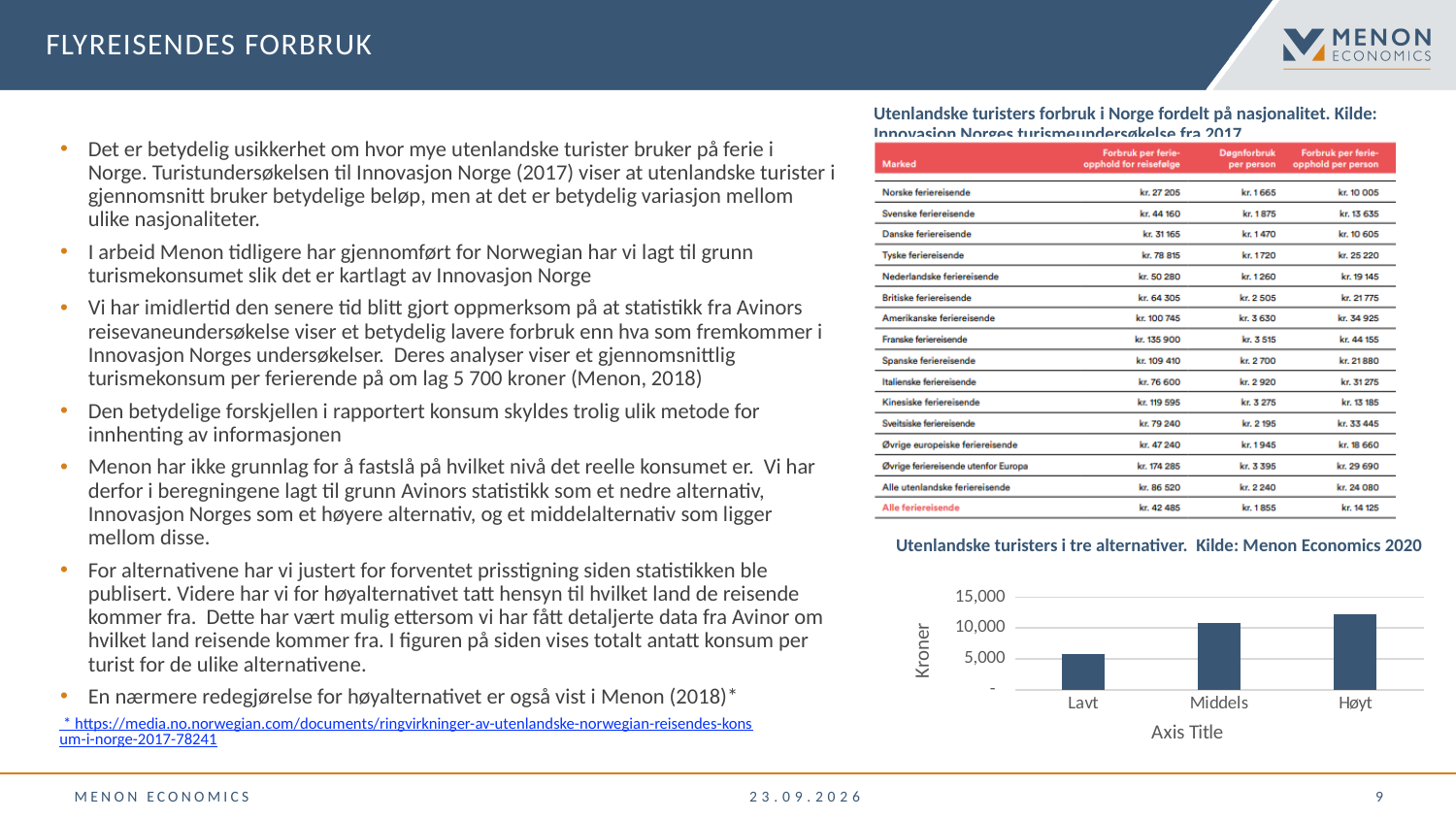
In the bar chart 'Utenlandske turisters i tre alternativer', how many categories are shown on the x axis? 3 What is the label shown under the horizontal axis of the bar chart 'Utenlandske turisters i tre alternativer'? Axis Title In the bar chart 'Utenlandske turisters i tre alternativer', is the value for Middels greater or less than 5,000? greater In the bar chart 'Utenlandske turisters i tre alternativer', is the value for Lavt greater or less than 10,000? less In the bar chart 'Utenlandske turisters i tre alternativer', do the values rise or fall from Lavt to Høyt along the x axis? rise In the bar chart 'Utenlandske turisters i tre alternativer', which category has the lowest value? Lavt In the bar chart 'Utenlandske turisters i tre alternativer', which is larger, the value for Middels or the value for Lavt? Middels In the bar chart 'Utenlandske turisters i tre alternativer', is the value for Høyt greater or less than 10,000? greater What is the label on the vertical axis of the bar chart 'Utenlandske turisters i tre alternativer'? Kroner In the bar chart 'Utenlandske turisters i tre alternativer', which category has the highest value? Høyt What kind of chart is shown under the title 'Utenlandske turisters i tre alternativer'? bar chart